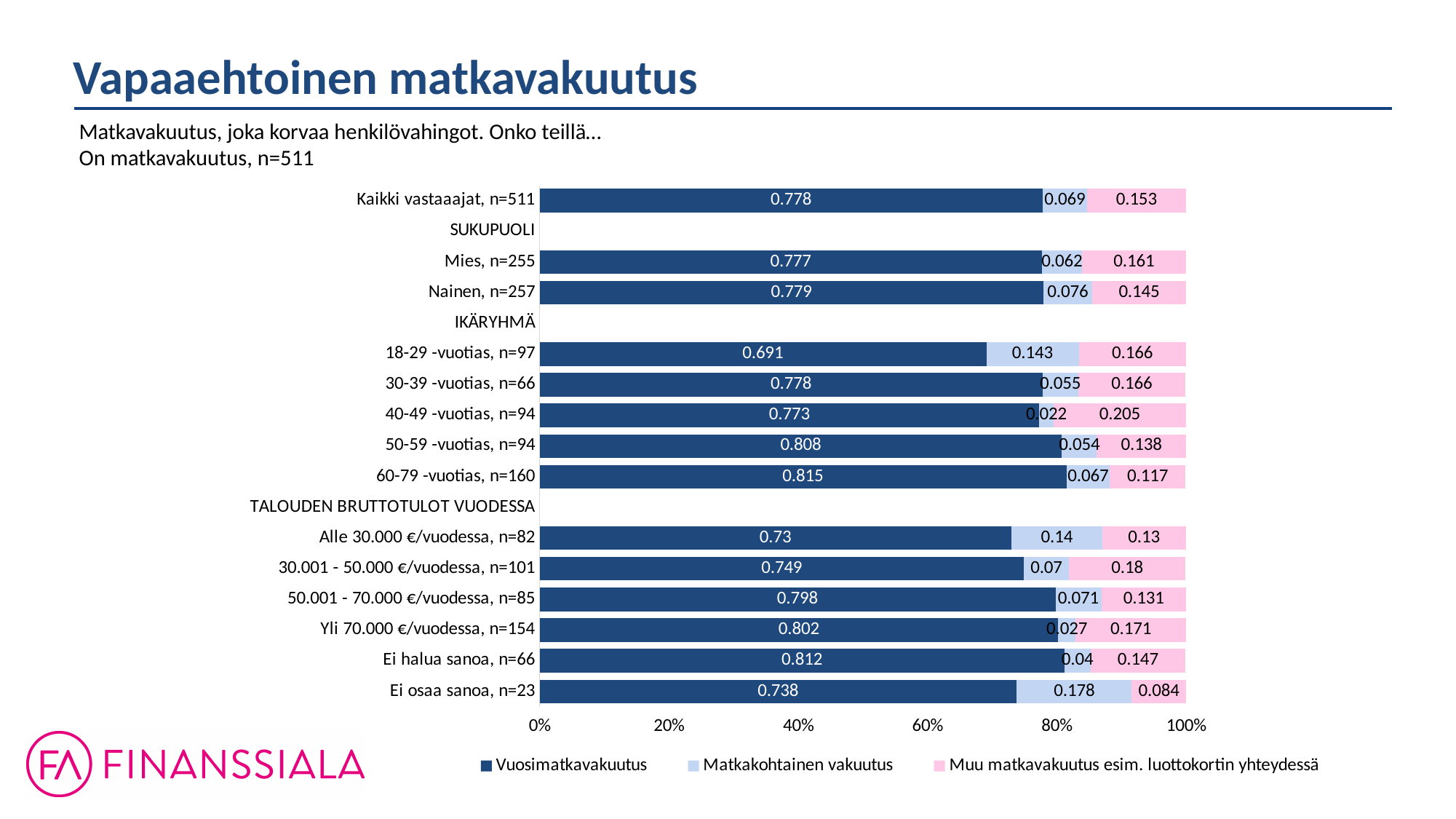
How many series does the legend list? 3 Is the Vuosimatkavakuutus value for 50-59 -vuotias, n=94 greater or less than 80%? greater Which category has the lowest Vuosimatkavakuutus value? 18-29 -vuotias, n=97 What kind of chart is shown on the slide? Stacked bar chart What is the Matkakohtainen vakuutus value for Ei osaa sanoa, n=23? 0.178 Which category has the lowest Matkakohtainen vakuutus value? 40-49 -vuotias, n=94 Which has a larger Matkakohtainen vakuutus value: Alle 30.000 €/vuodessa, n=82 or Yli 70.000 €/vuodessa, n=154? Alle 30.000 €/vuodessa, n=82 Which category has the highest Vuosimatkavakuutus value? 60-79 -vuotias, n=160 What is the difference between the Vuosimatkavakuutus values for 60-79 -vuotias, n=160 and 18-29 -vuotias, n=97? 0.124 What is the Muu matkavakuutus esim. luottokortin yhteydessä value for 40-49 -vuotias, n=94? 0.205 How many categories have bars plotted in the chart? 14 What is the Vuosimatkavakuutus value for Kaikki vastaaajat, n=511? 0.778